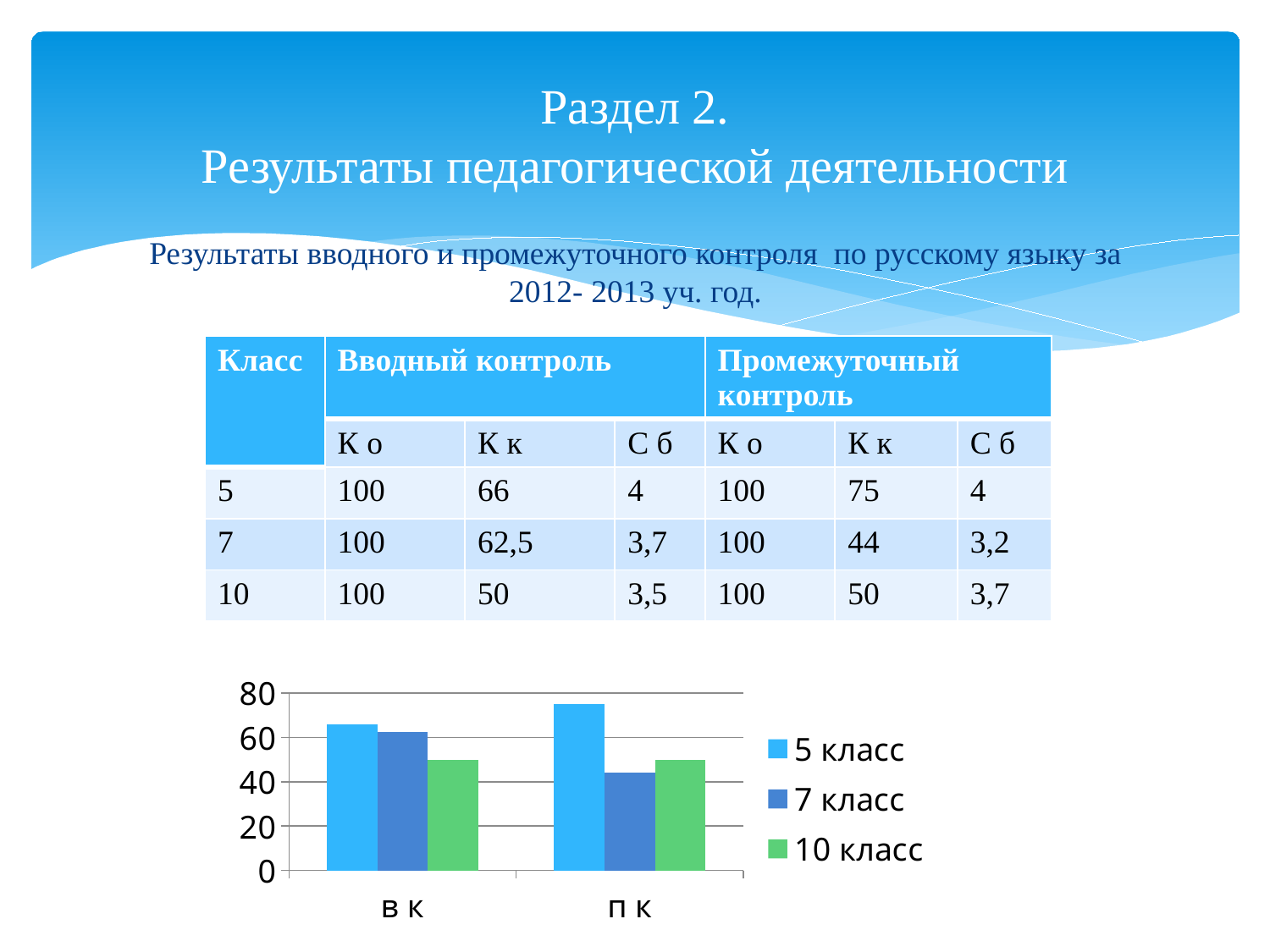
What are the labels of the two categories on the x axis of the chart? В К and П К Is the value for 5 класс in the П К category greater or less than 60? greater For 7 класс, which category has the larger bar, В К or П К? В К Which series has the highest bar in the П К category? 5 класс How many series does the chart legend list? 3 Which series has the lowest bar in the В К category? 10 класс Is the value for 10 класс in the В К category greater or less than 60? less What kind of chart is shown on the slide? bar chart Is the value for 7 класс in the П К category greater or less than 60? less For 5 класс, which category has the larger bar, В К or П К? П К Which series has the lowest bar in the П К category? 7 класс How many categories are shown on the x axis of the chart? 2